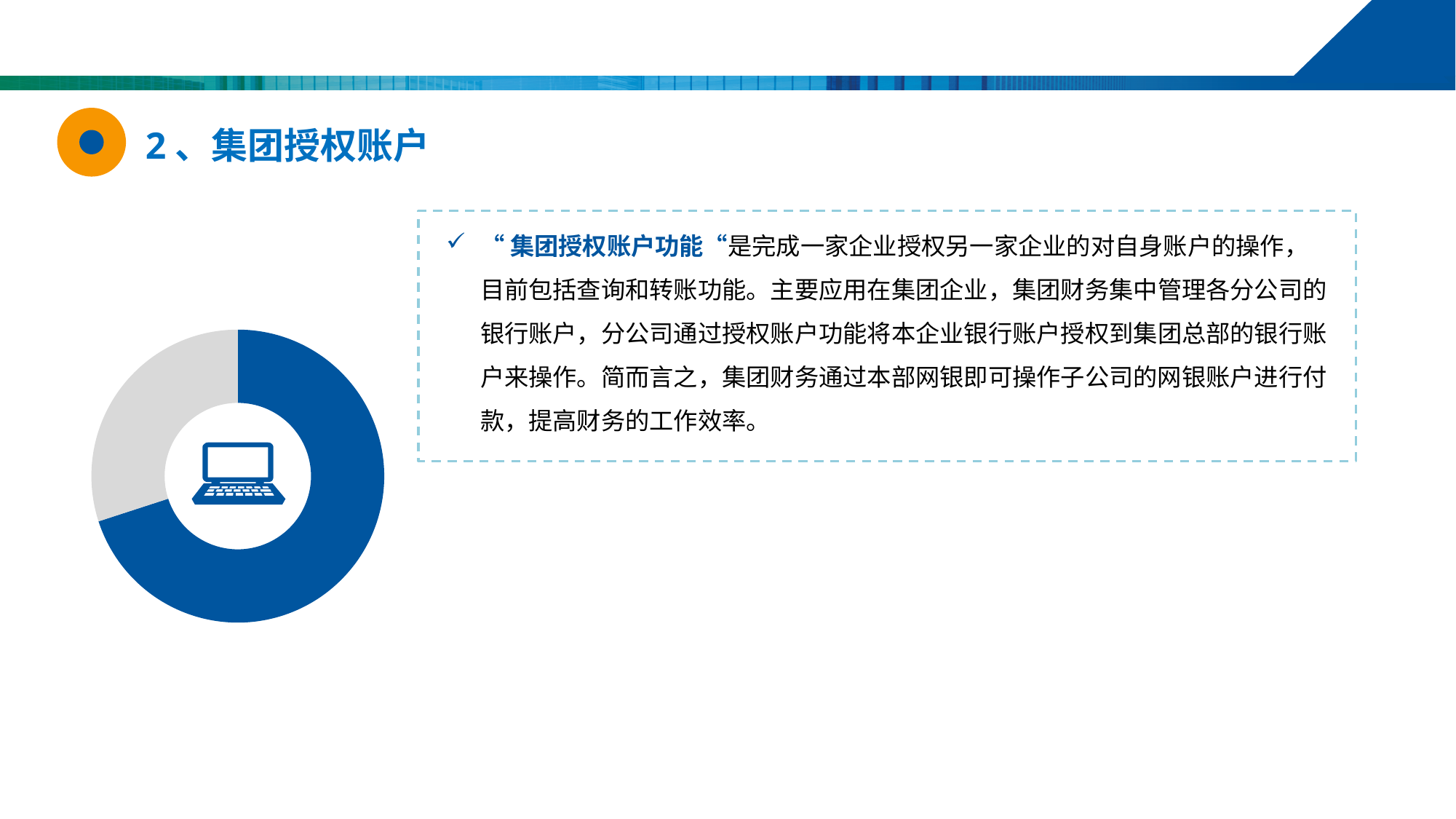
What colours are the two slices of the doughnut chart on the left of the slide? Blue and grey How many slices does the doughnut chart on the left of the slide have? 2 What kind of chart is shown on the left of the slide? Doughnut (pie) chart Does the doughnut chart on the left of the slide show any data labels or a legend? No In the doughnut chart on the left of the slide, which slice is larger, the blue one or the grey one? The blue one